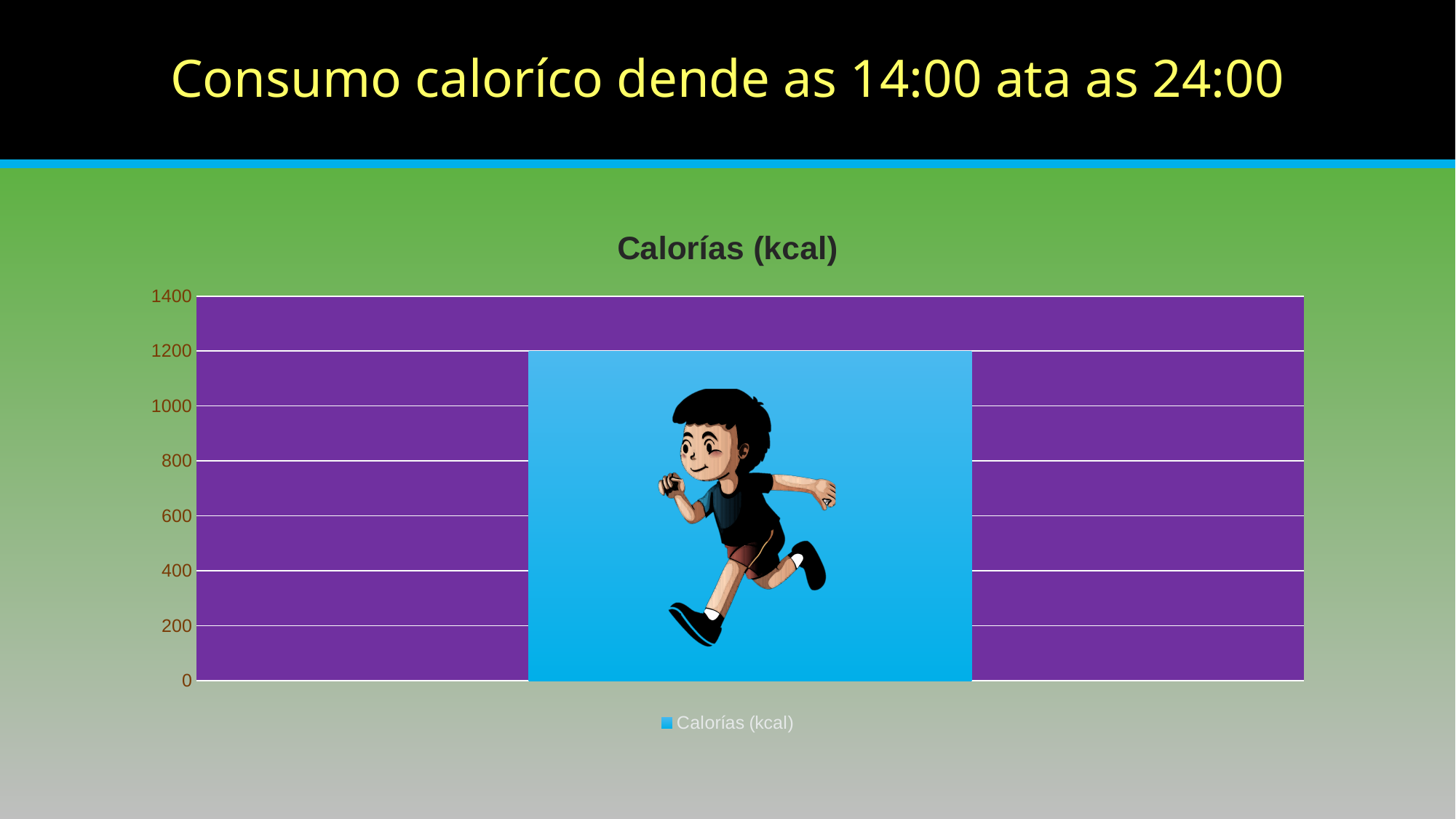
What is the highest value shown on the y axis of the chart? 1400 How many series does the legend list? 1 What value does the single bar in the chart reach on the y axis? 1200 Is the value of the bar greater or less than 1400? less What is the title of the chart? Calorías (kcal) How many bars are plotted in the chart? 1 What is the name of the series shown in the legend? Calorías (kcal) Is the value of the bar greater or less than 1000? greater What kind of chart is shown on the slide? bar chart